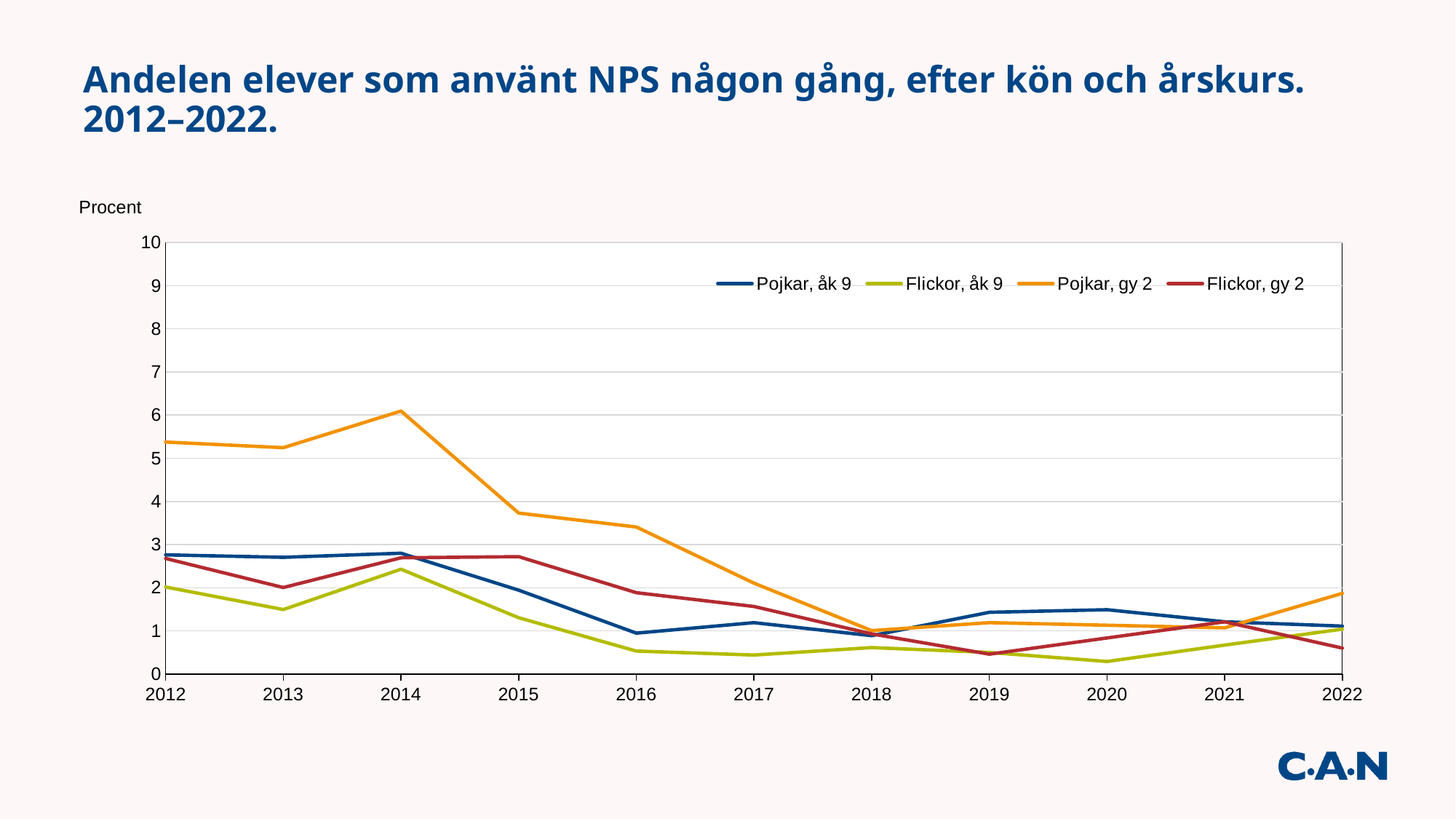
What kind of chart is shown on the slide? Line chart Is the value for Pojkar, gy 2 in 2012 greater or less than 5? greater How many years are shown on the x axis? 11 Is the value for Flickor, åk 9 in 2020 greater or less than 1? less Which series has the lowest value in 2020? Flickor, åk 9 In 2016, which is larger: Pojkar, åk 9 or Flickor, åk 9? Pojkar, åk 9 What is the label shown above the y axis? Procent In which year does the Pojkar, gy 2 series reach its highest value? 2014 Which series has the highest value in 2014? Pojkar, gy 2 Does the Pojkar, gy 2 series rise or fall from 2014 to 2018? Fall Is the value for Pojkar, gy 2 in 2015 greater or less than 4? less How many series does the legend list? 4